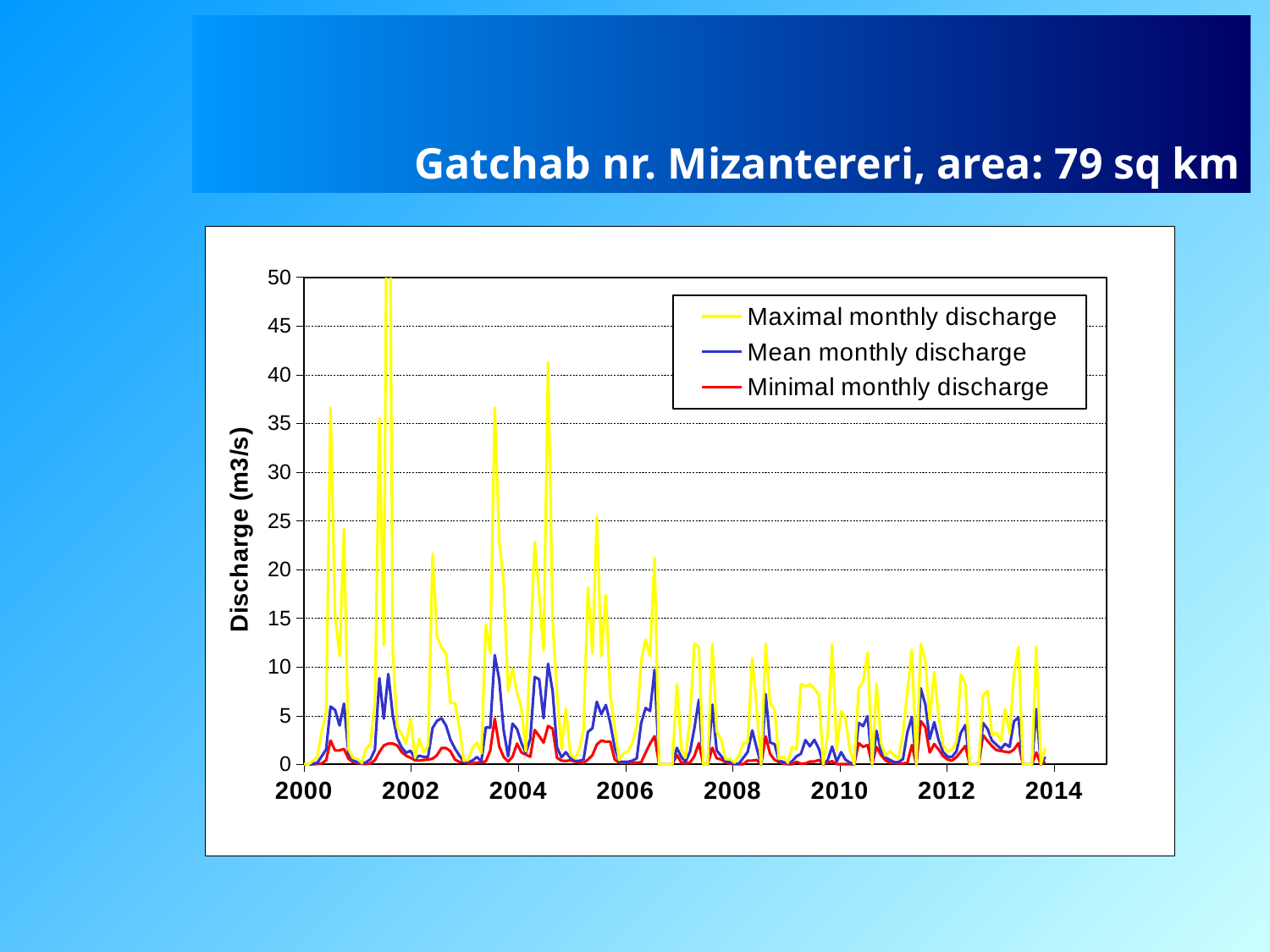
What kind of chart is shown on the slide? line chart Do the peaks of the maximal monthly discharge generally rise or fall from 2000 to 2014? fall Is the peak of the maximal monthly discharge around 2010 greater or less than 20 m3/s? less Is the highest peak of the mean monthly discharge greater or less than 20 m3/s? less Is the highest peak of the maximal monthly discharge around 2001 greater or less than 45 m3/s? greater Which series is plotted in yellow? Maximal monthly discharge Which series has the lowest values throughout the chart? Minimal monthly discharge How many series does the legend list? 3 Which series has the highest values throughout the chart? Maximal monthly discharge What is the label of the vertical axis? Discharge (m3/s) What is the maximum value shown on the vertical axis? 50